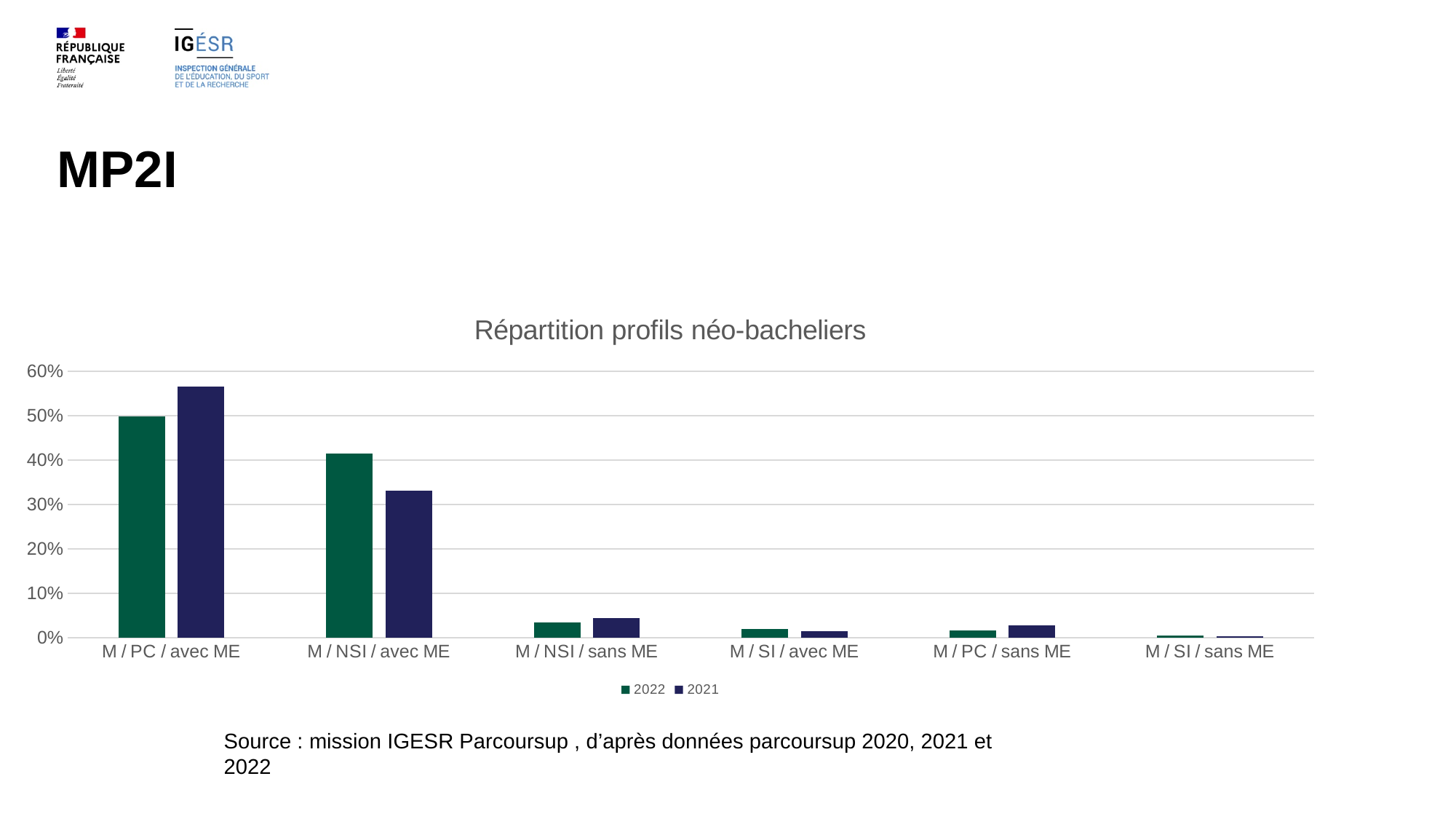
Which category has the lowest value for the 2022 series? M / SI / sans ME For M / PC / avec ME, which series has the larger value, 2022 or 2021? 2021 What is the title of the chart? Répartition profils néo-bacheliers What type of chart is shown on the slide? bar chart Is the 2021 value for M / PC / avec ME greater or less than 50%? greater How many categories are shown on the x axis? 6 Is the 2021 value for M / NSI / sans ME greater or less than 10%? less Which category has the highest value for the 2021 series? M / PC / avec ME How many series does the legend list? 2 Is the 2022 value for M / NSI / avec ME greater or less than 30%? greater For M / NSI / avec ME, which series has the larger value, 2022 or 2021? 2022